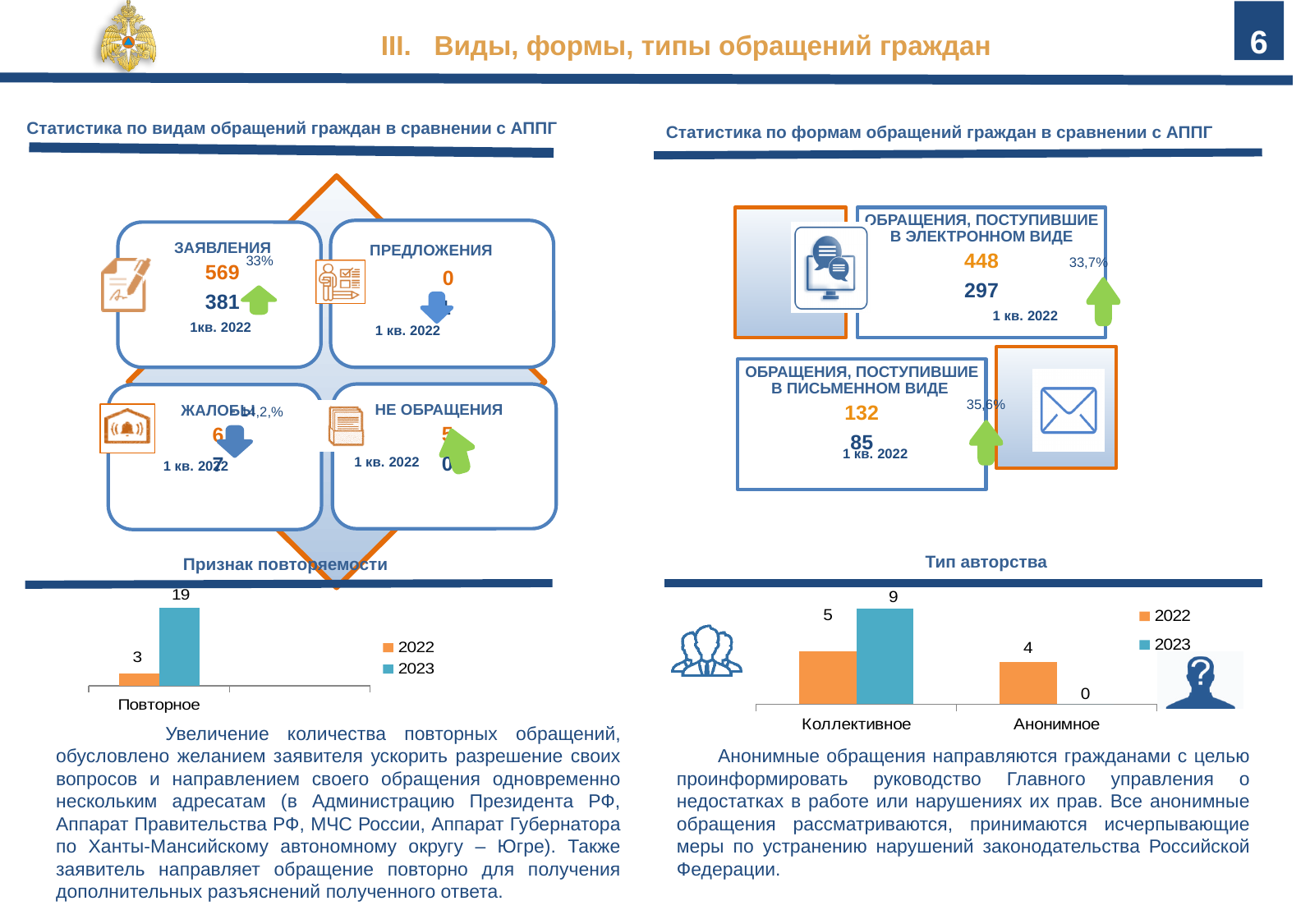
In the 'Признак повторяемости' chart, what is the value for 2022 for 'Повторное'? 3 In the 'Тип авторства' chart, what is the 2023 value for 'Анонимное'? 0 What kind of chart is the 'Признак повторяемости' chart? bar chart In the 'Тип авторства' chart, which category has the highest 2023 value? Коллективное In the 'Тип авторства' chart, what is the difference between the 2023 and 2022 values for 'Коллективное'? 4 In the 'Тип авторства' chart, what is the 2022 value for 'Анонимное'? 4 In the 'Признак повторяемости' chart, how many series does the legend list? 2 In the 'Тип авторства' chart, how many categories are shown on the x axis? 2 In the 'Признак повторяемости' chart, what is the value for 2023 for 'Повторное'? 19 In the 'Тип авторства' chart, which is larger for 'Коллективное': the 2022 value or the 2023 value? 2023 In the 'Признак повторяемости' chart, what is the difference between the 2023 and 2022 values for 'Повторное'? 16 In the 'Тип авторства' chart, what is the 2023 value for 'Коллективное'? 9